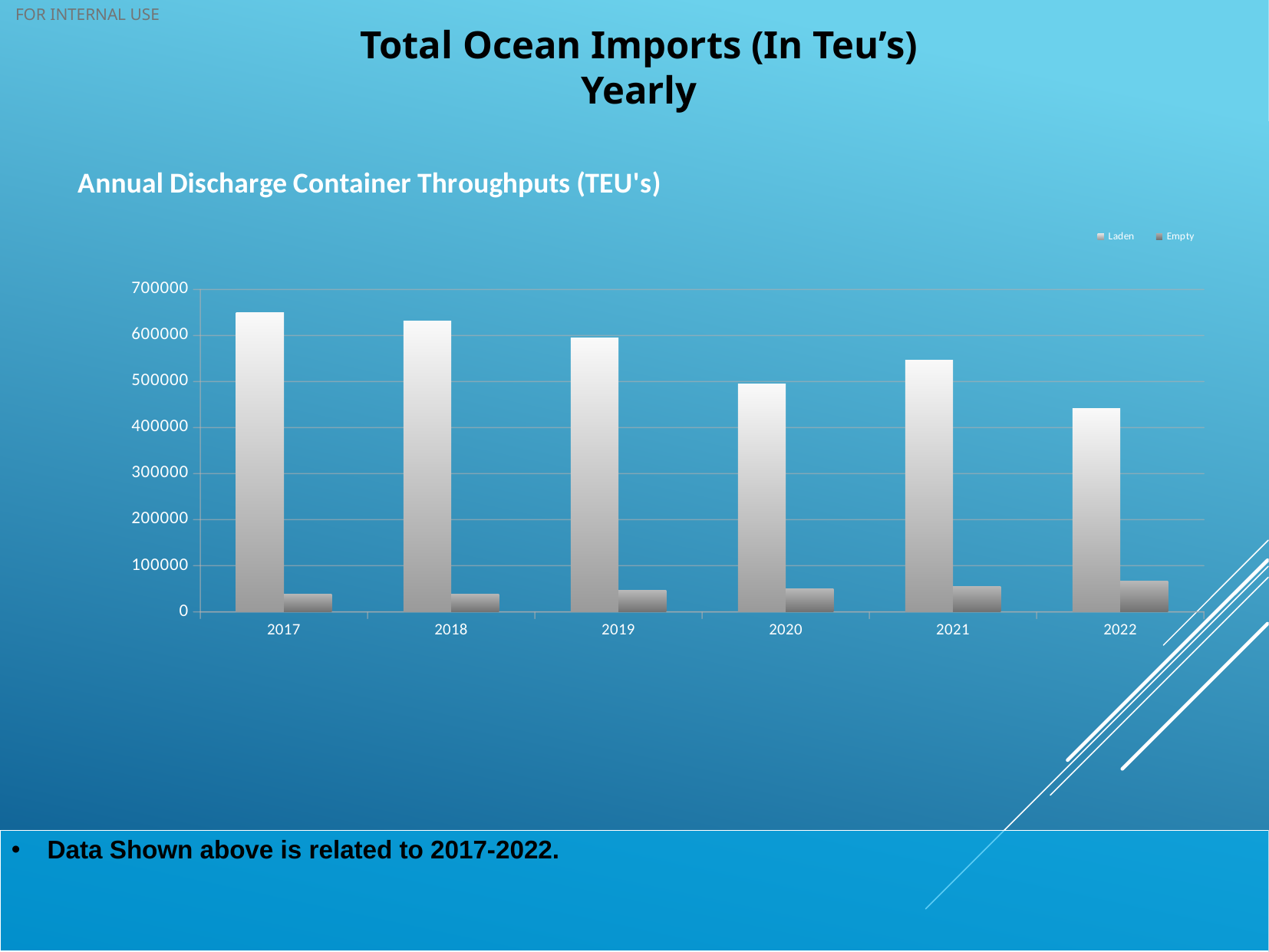
What is the title of the chart? Annual Discharge Container Throughputs (TEU's) How many series does the chart's legend list? 2 Do the Empty values generally rise or fall from 2017 to 2022? rise Which year has the lowest Laden value? 2022 Which year has the highest Empty value? 2022 Is the Laden value for 2017 greater or less than 600000? greater Which is larger, the Laden value for 2020 or the Laden value for 2021? 2021 What kind of chart is shown on the slide? bar chart What are the two series named in the chart's legend? Laden and Empty Which year has the highest Laden value? 2017 How many years are shown on the x axis of the chart? 6 Is the Laden value for 2022 greater or less than 500000? less